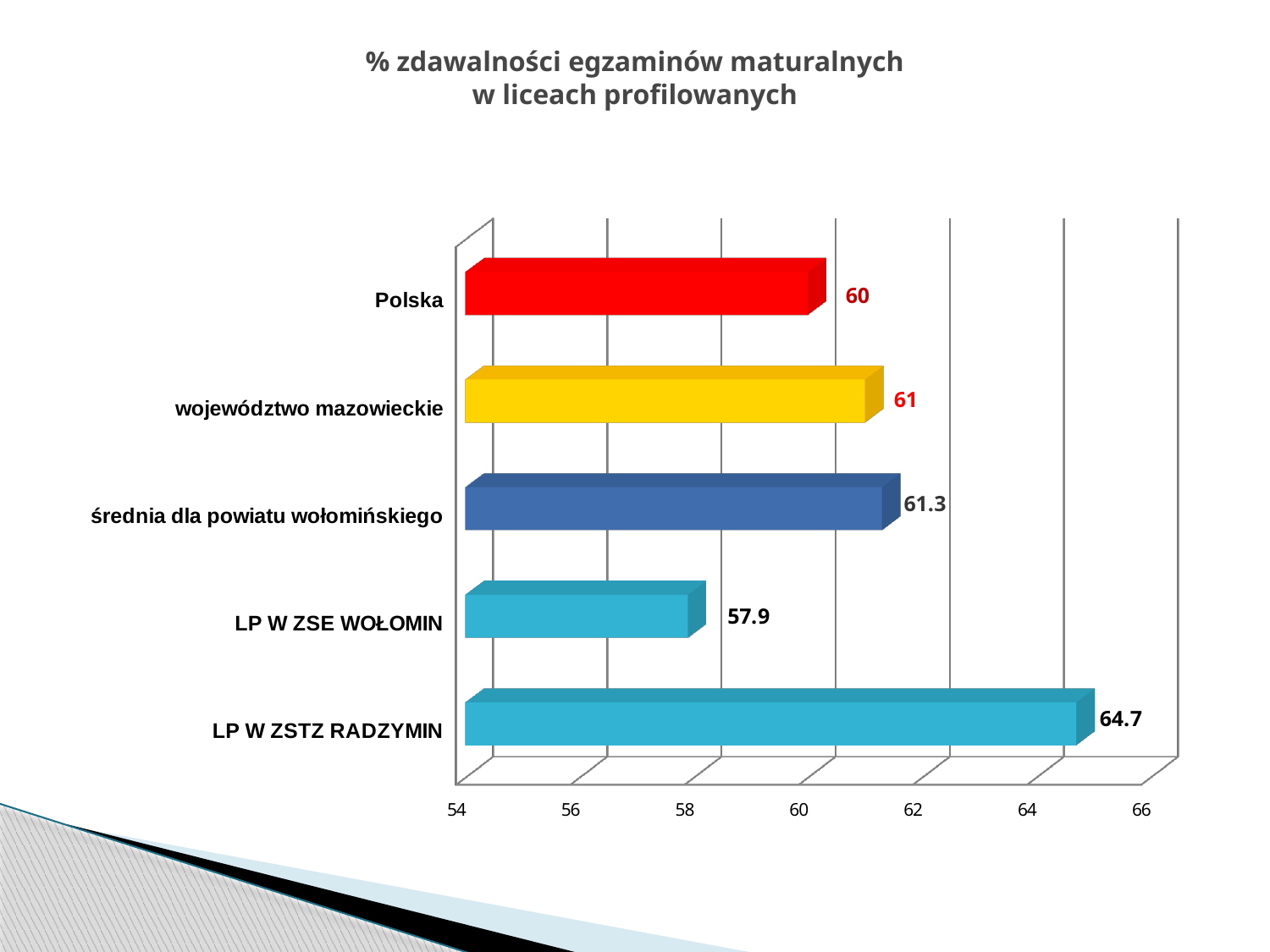
What is the value for LP W ZSE WOŁOMIN? 57.9 What is the value for Polska? 60 Which category has the highest value? LP W ZSTZ RADZYMIN What kind of chart is shown on the slide? bar chart Which category has the lowest value? LP W ZSE WOŁOMIN What is the value for średnia dla powiatu wołomińskiego? 61.3 What is the difference between the values for LP W ZSTZ RADZYMIN and LP W ZSE WOŁOMIN? 6.8 What is the value for LP W ZSTZ RADZYMIN? 64.7 Which is larger, the value for Polska or the value for województwo mazowieckie? województwo mazowieckie What is the title of the chart? % zdawalności egzaminów maturalnych w liceach profilowanych What is the value for województwo mazowieckie? 61 How many categories are shown in the chart? 5